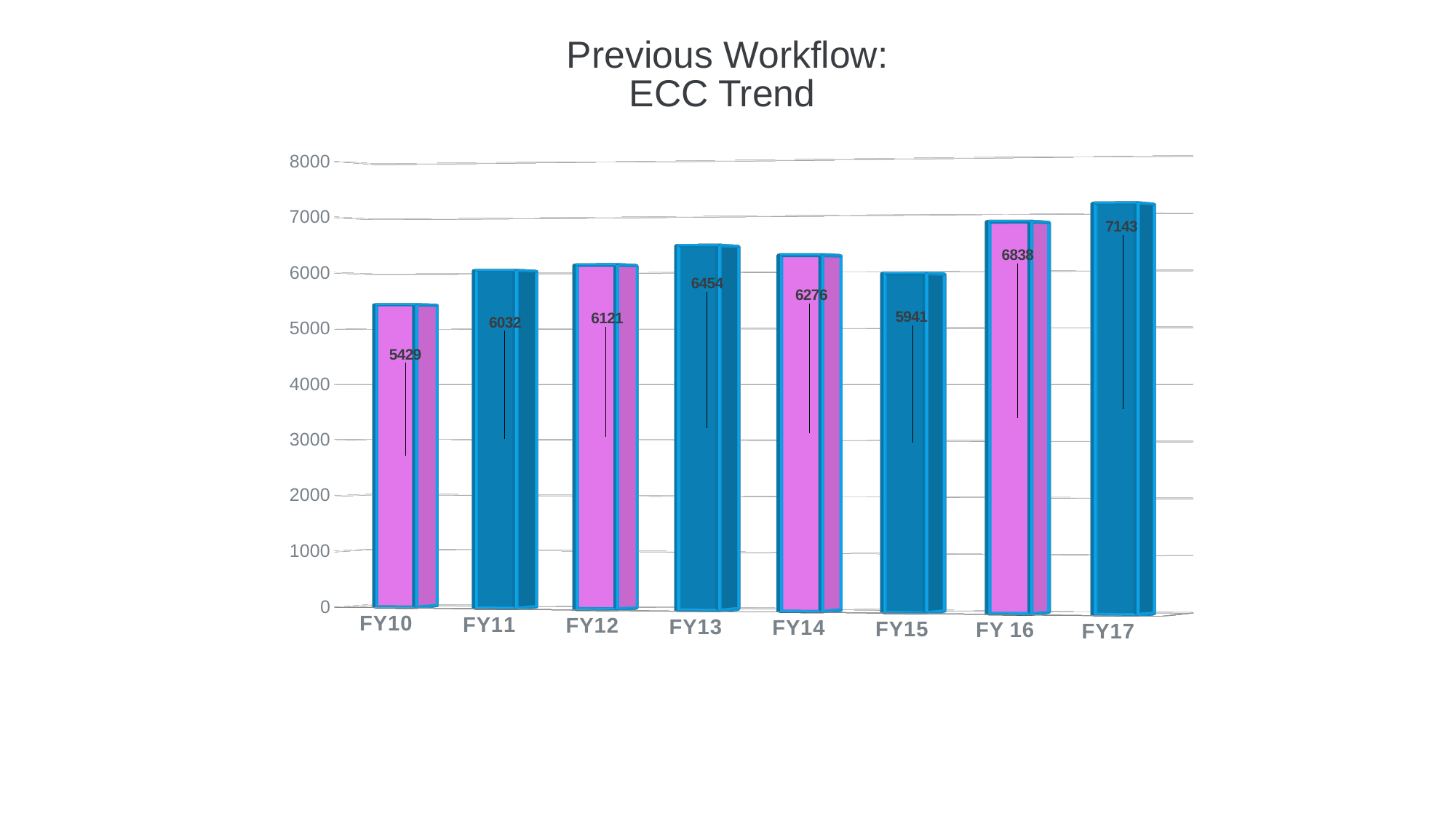
Which fiscal year has the lowest value? FY10 What is the value for FY13? 6454 Which fiscal year has the highest value? FY17 What is the title of the chart? Previous Workflow: ECC Trend Is the value for FY 16 greater or less than 6000? greater What kind of chart is shown on the slide? bar chart How many fiscal years are shown on the chart? 8 What is the difference between the values for FY17 and FY10? 1714 Which is larger, the value for FY12 or the value for FY15? FY12 What is the difference between the values for FY13 and FY14? 178 What is the value for FY10? 5429 What is the value for FY17? 7143